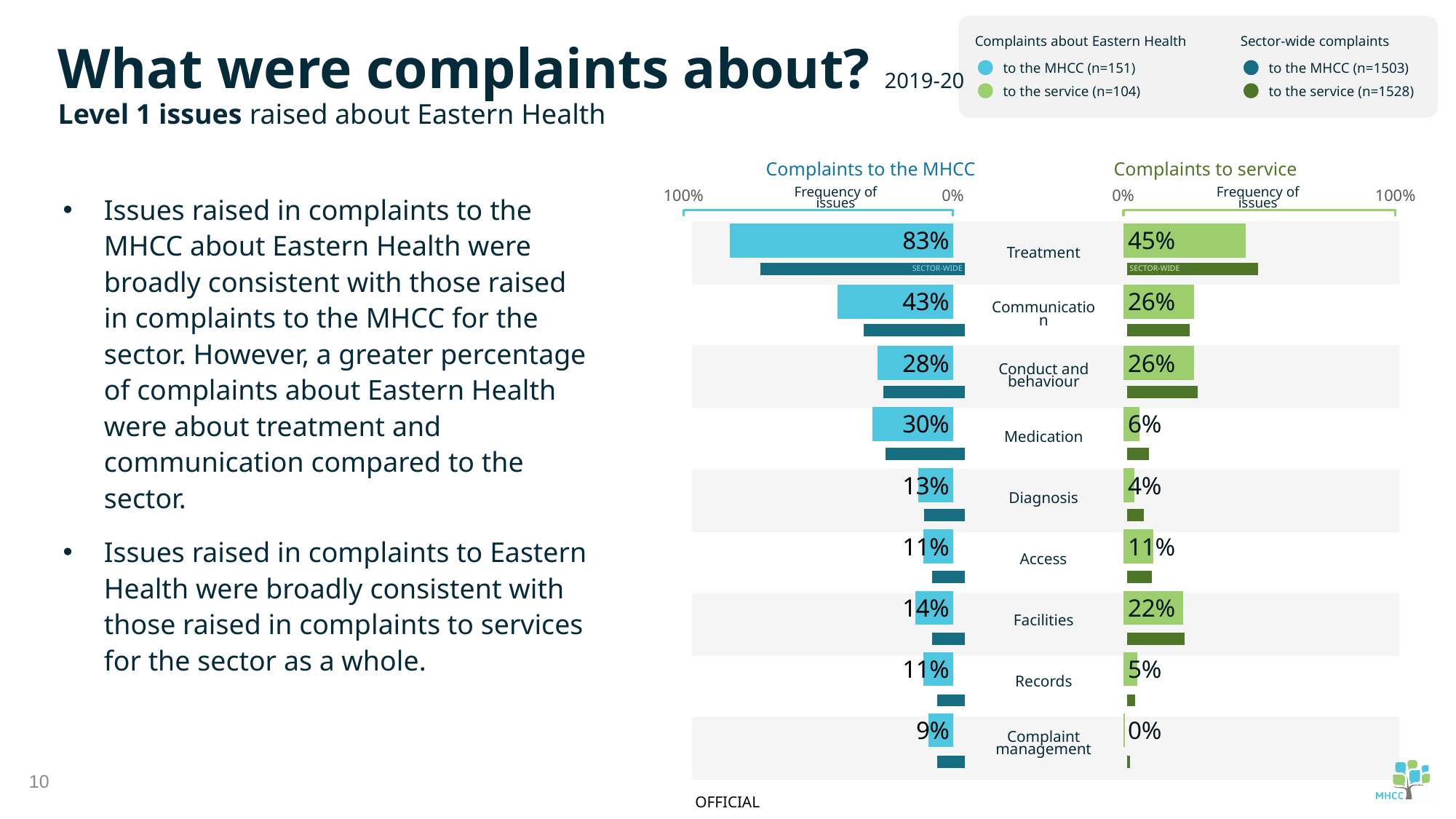
In the 'Complaints to the MHCC' chart, which is larger for Eastern Health: Medication or Conduct and behaviour? Medication What kind of chart is the 'Complaints to service' chart? Bar chart In the 'Complaints to service' chart, what is the value for Medication for Eastern Health? 6% How many series does the legend at the top right of the slide list? 4 How many issue categories are shown in the 'Complaints to the MHCC' chart? 9 In the 'Complaints to service' chart, which issue has the lowest frequency for Eastern Health? Complaint management In the 'Complaints to the MHCC' chart, what percentage of complaints about Eastern Health were about Treatment? 83% According to the legend, how many complaints about Eastern Health were made to the MHCC (n)? 151 In the 'Complaints to the MHCC' chart, which issue has the highest frequency for Eastern Health? Treatment In the 'Complaints to the MHCC' chart, what is the difference between the Eastern Health values for Treatment and Communication? 40 percentage points In the 'Complaints to service' chart, what is the value for Facilities for Eastern Health? 22% In the 'Complaints to the MHCC' chart, is the sector-wide value for Treatment greater or less than 50%? greater